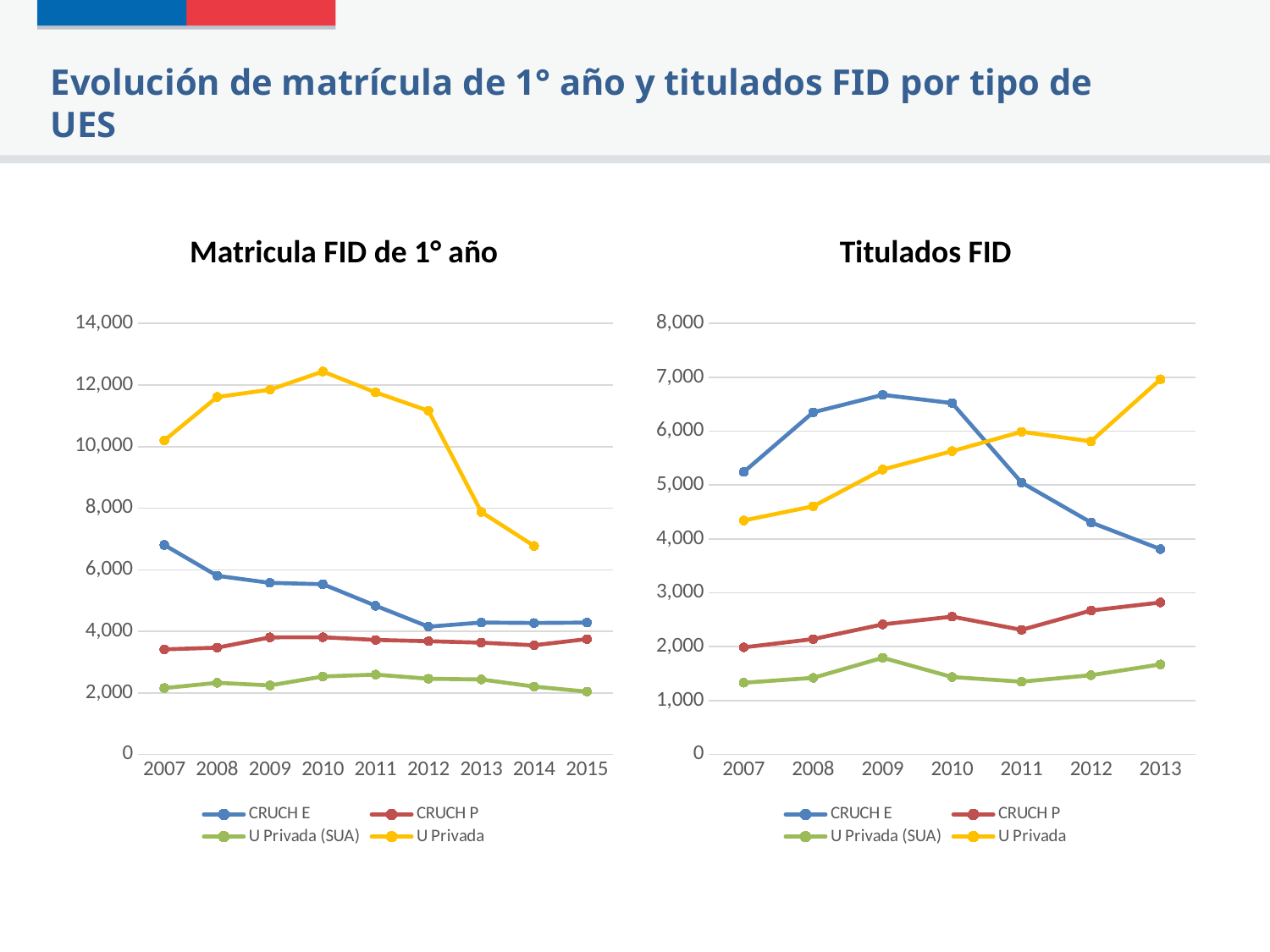
In the 'Matricula FID de 1° año' chart, is the value for U Privada in 2010 greater or less than 12,000? greater In the 'Titulados FID' chart, which series has the lowest value in 2011? U Privada (SUA) In the 'Matricula FID de 1° año' chart, how many series does the legend list? 4 In the 'Titulados FID' chart, which series has the highest value in 2013? U Privada In the 'Matricula FID de 1° año' chart, does the CRUCH E line rise or fall from 2007 to 2012? fall In the 'Matricula FID de 1° año' chart, is the value for CRUCH E in 2007 greater or less than 6,000? greater What kind of chart is the 'Matricula FID de 1° año' chart? line chart In the 'Titulados FID' chart, how many years are shown on the x axis? 7 In the 'Matricula FID de 1° año' chart, how many years are shown on the x axis? 9 In the 'Titulados FID' chart, which is larger in 2008: CRUCH E or U Privada? CRUCH E In the 'Titulados FID' chart, is the value for CRUCH E in 2009 greater or less than 6,000? greater In the 'Matricula FID de 1° año' chart, which series has the highest value in 2010? U Privada